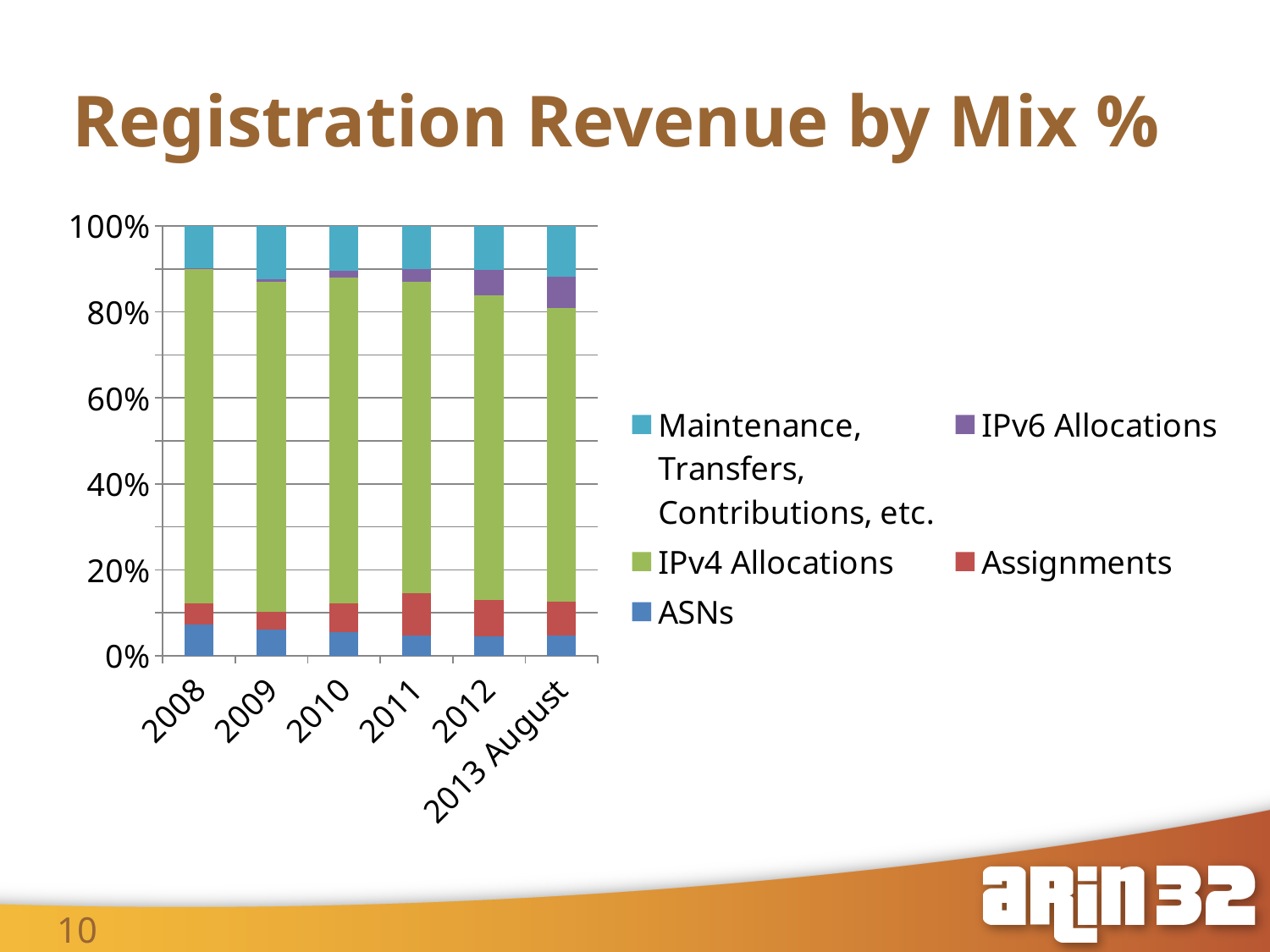
What is the total of the stacked bar for 2010? 100% How many categories are shown along the x axis of the chart? 6 Is the ASNs segment for 2008 greater or less than 20%? less What is the title of the chart on the slide? Registration Revenue by Mix % Which colour represents IPv4 Allocations in the chart? Green Is the Maintenance, Transfers, Contributions, etc. segment for 2013 August greater or less than 20%? less Which category has the largest IPv6 Allocations segment? 2013 August Does the IPv6 Allocations share rise or fall from 2008 to 2013 August? Rise Is the IPv6 Allocations segment larger in 2009 or in 2013 August? 2013 August What kind of chart is shown on the slide? Stacked bar chart How many series does the chart's legend list? 5 Is the IPv4 Allocations segment for 2008 greater or less than 60%? greater